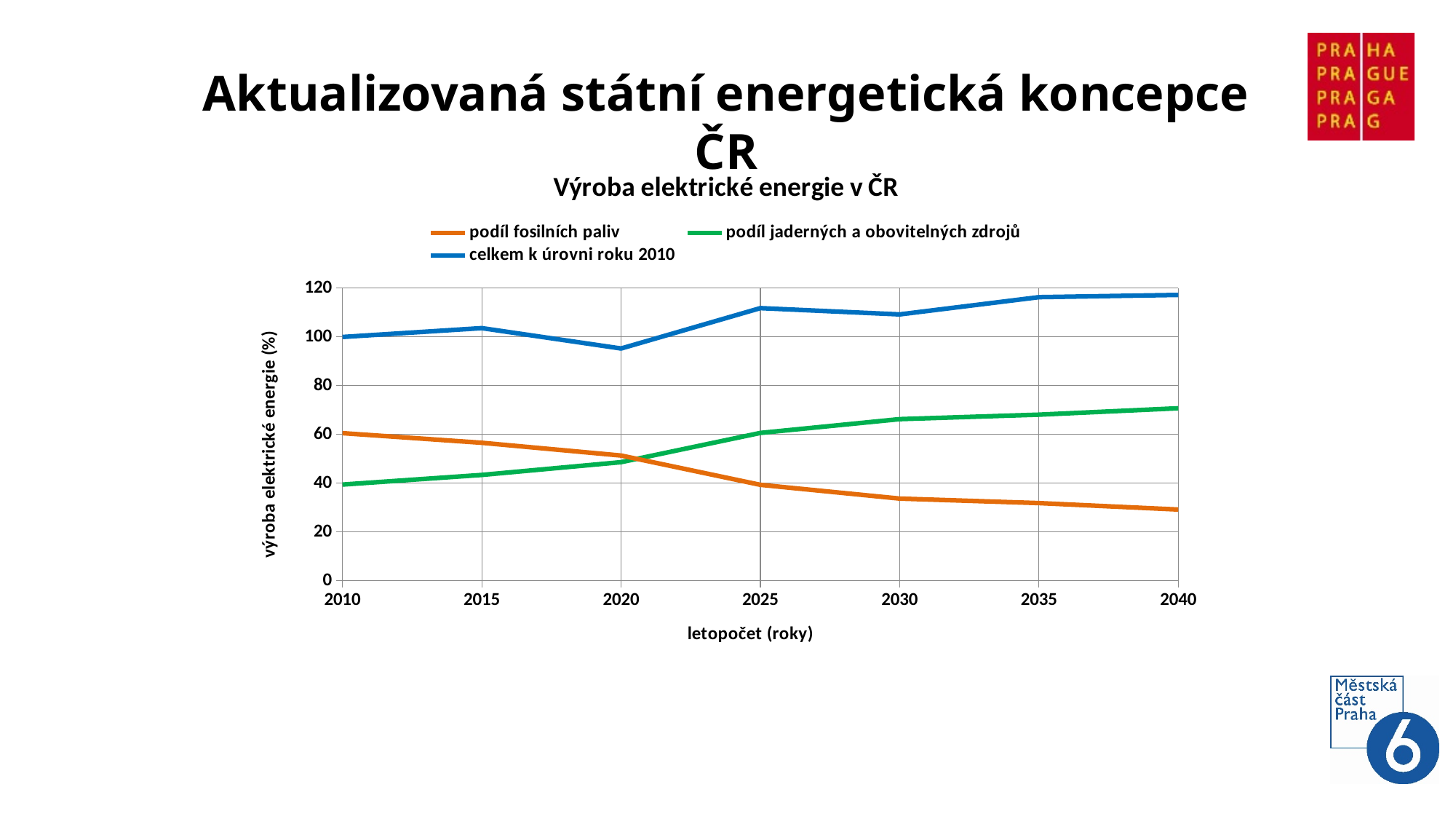
Does the value for 'podíl fosilních paliv' rise or fall from 2010 to 2040? fall Does the value for 'podíl jaderných a obovitelných zdrojů' rise or fall from 2010 to 2040? rise Is the value for 'podíl jaderných a obovitelných zdrojů' in 2040 greater or less than 60? greater What is the label of the x axis? letopočet (roky) Is the value for 'celkem k úrovni roku 2010' in 2020 greater or less than 100? less What is the title of the chart? Výroba elektrické energie v ČR How many series does the legend list? 3 In 2010, which is larger: 'podíl fosilních paliv' or 'podíl jaderných a obovitelných zdrojů'? podíl fosilních paliv How many years are marked on the x axis? 7 What kind of chart is shown on the slide? line chart In which year is the value for 'celkem k úrovni roku 2010' lowest? 2020 Is the value for 'podíl fosilních paliv' in 2040 greater or less than 40? less